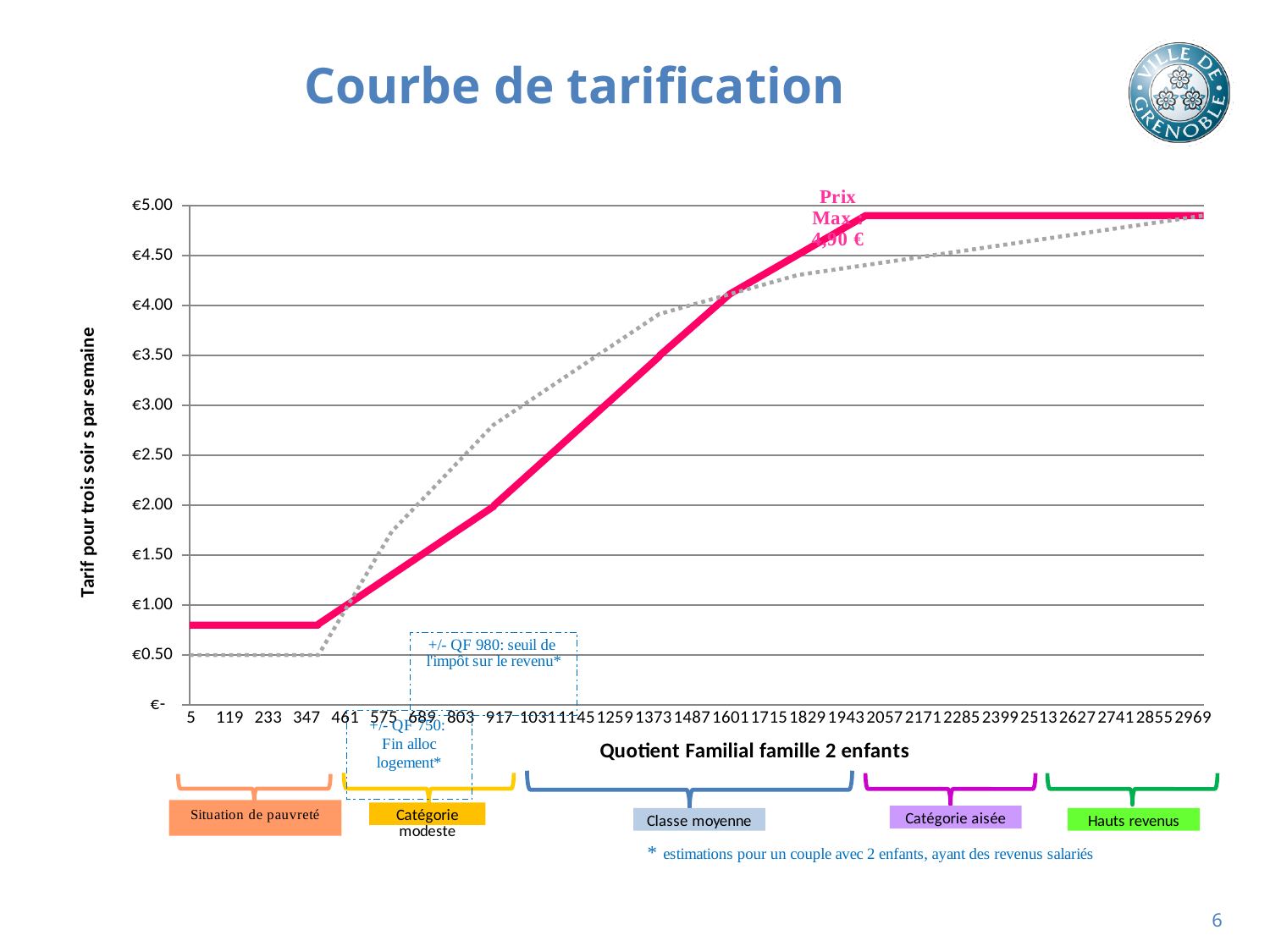
Does the pink line rise or fall between Quotient Familial 461 and 1601? rise At Quotient Familial 803, which line is higher, the pink solid line or the grey dotted line? grey dotted line What is the value of the grey dotted line at Quotient Familial 5? €0.50 Is the value of the pink line at Quotient Familial 2285 greater or less than €4.50? greater How many lines are plotted on the chart? 2 What is the title of the vertical axis? Tarif pour trois soirs par semaine What is the maximum price (Prix Max) labelled on the pink line? 4,90 € Is the value of the pink line at Quotient Familial 5 greater or less than €1.00? less Is the value of the pink line at Quotient Familial 1259 greater or less than €2.50? greater At Quotient Familial 2285, which line is higher, the pink solid line or the grey dotted line? pink solid line What kind of chart is shown on the slide? line chart